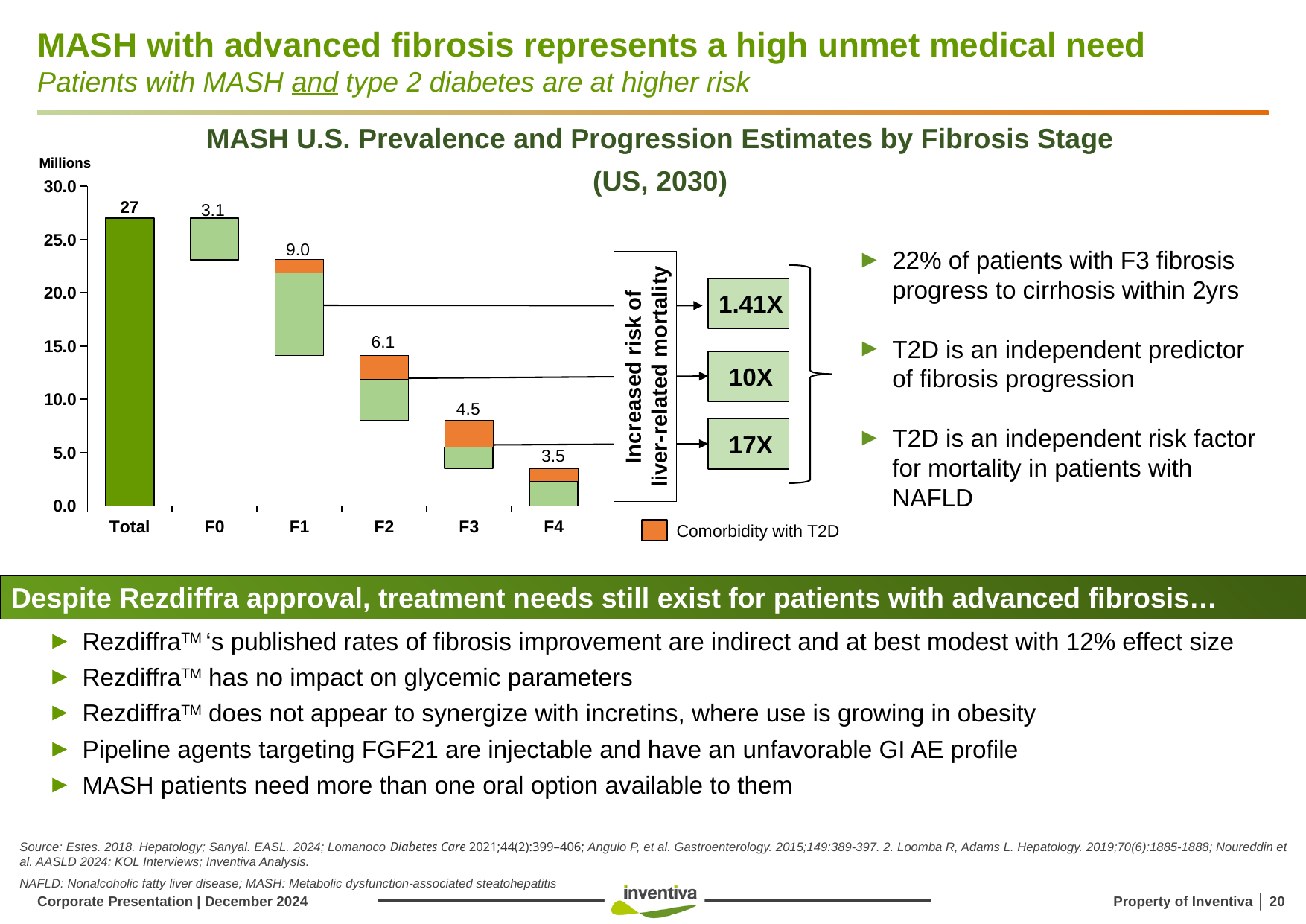
What kind of chart is used to show the prevalence estimates by fibrosis stage? Bar chart How many categories are shown on the x axis of the chart? 6 What value is labelled on the F4 bar? 3.5 What does the orange colour in the chart represent according to the legend? Comorbidity with T2D What unit is shown on the y axis of the chart? Millions Which is larger, the value for F2 or the value for F3? F2 Among the fibrosis stages F0 to F4, which stage has the highest value? F1 Among the fibrosis stages F0 to F4, which stage has the lowest value? F0 What is the value shown for the Total bar? 27 What value is labelled on the F1 bar? 9.0 What is the difference between the F1 value and the F2 value? 2.9 What value is labelled on the F3 bar? 4.5